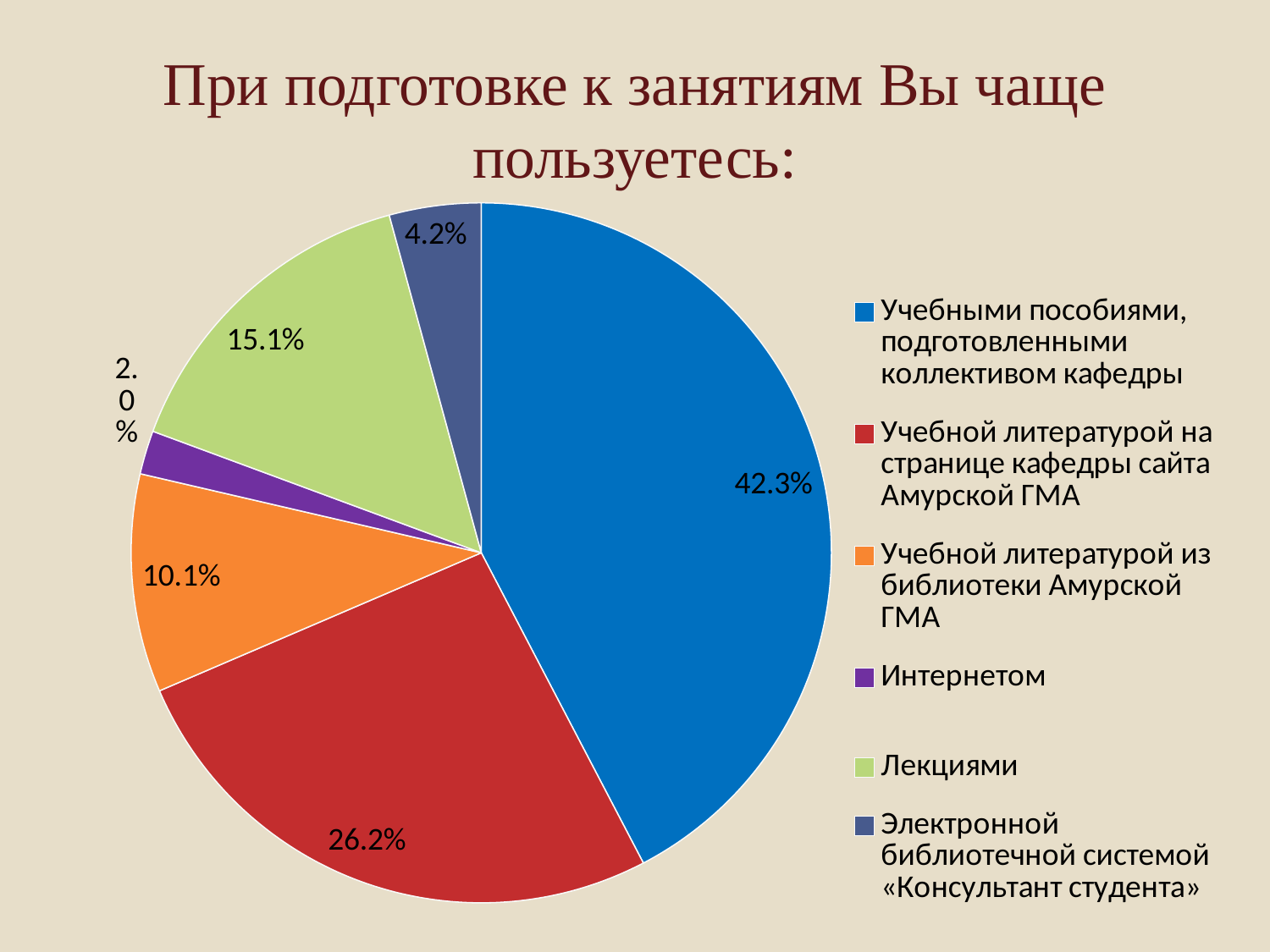
What is the value for «Лекциями»? 15.1% What type of chart is shown on the slide? pie chart Which category has the largest share of the pie? Учебными пособиями, подготовленными коллективом кафедры What is the difference between the shares for «Учебными пособиями, подготовленными коллективом кафедры» and «Учебной литературой на странице кафедры сайта Амурской ГМА»? 16.1% What is the value for «Учебной литературой на странице кафедры сайта Амурской ГМА»? 26.2% What is the value for «Интернетом»? 2.0% What is the title of the chart? При подготовке к занятиям Вы чаще пользуетесь: What share of the pie is labelled for «Учебными пособиями, подготовленными коллективом кафедры»? 42.3% How many slices does the pie chart have? 6 Which category has the smallest share of the pie? Интернетом Which is larger: the share for «Лекциями» or the share for «Учебной литературой из библиотеки Амурской ГМА»? Лекциями What is the value for «Электронной библиотечной системой «Консультант студента»»? 4.2%